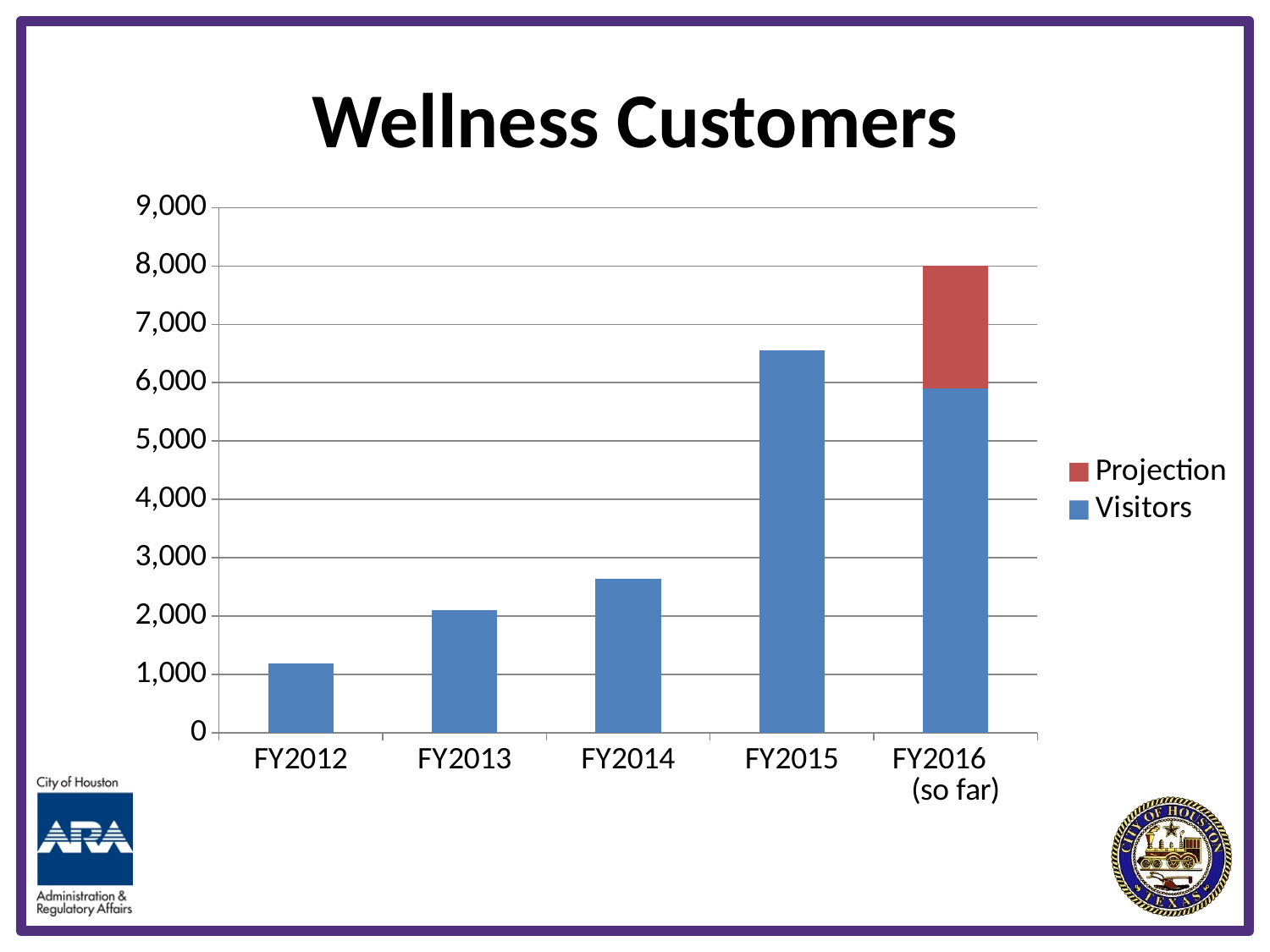
What is the title of the chart? Wellness Customers What kind of chart is shown on the slide? bar chart Is the Visitors value for FY2015 greater or less than 6,000? greater Which is larger, the Visitors value for FY2013 or for FY2014? FY2014 How many series does the legend list? 2 How many fiscal year categories are shown on the x axis? 5 Is the Visitors value for FY2014 greater or less than 3,000? less Which fiscal year has the lowest Visitors value? FY2012 Is the Visitors value for FY2012 greater or less than 2,000? less Do the Visitors values rise or fall from FY2012 to FY2015? rise Which series is shown in red in the legend? Projection Which fiscal year has the highest Visitors value? FY2015